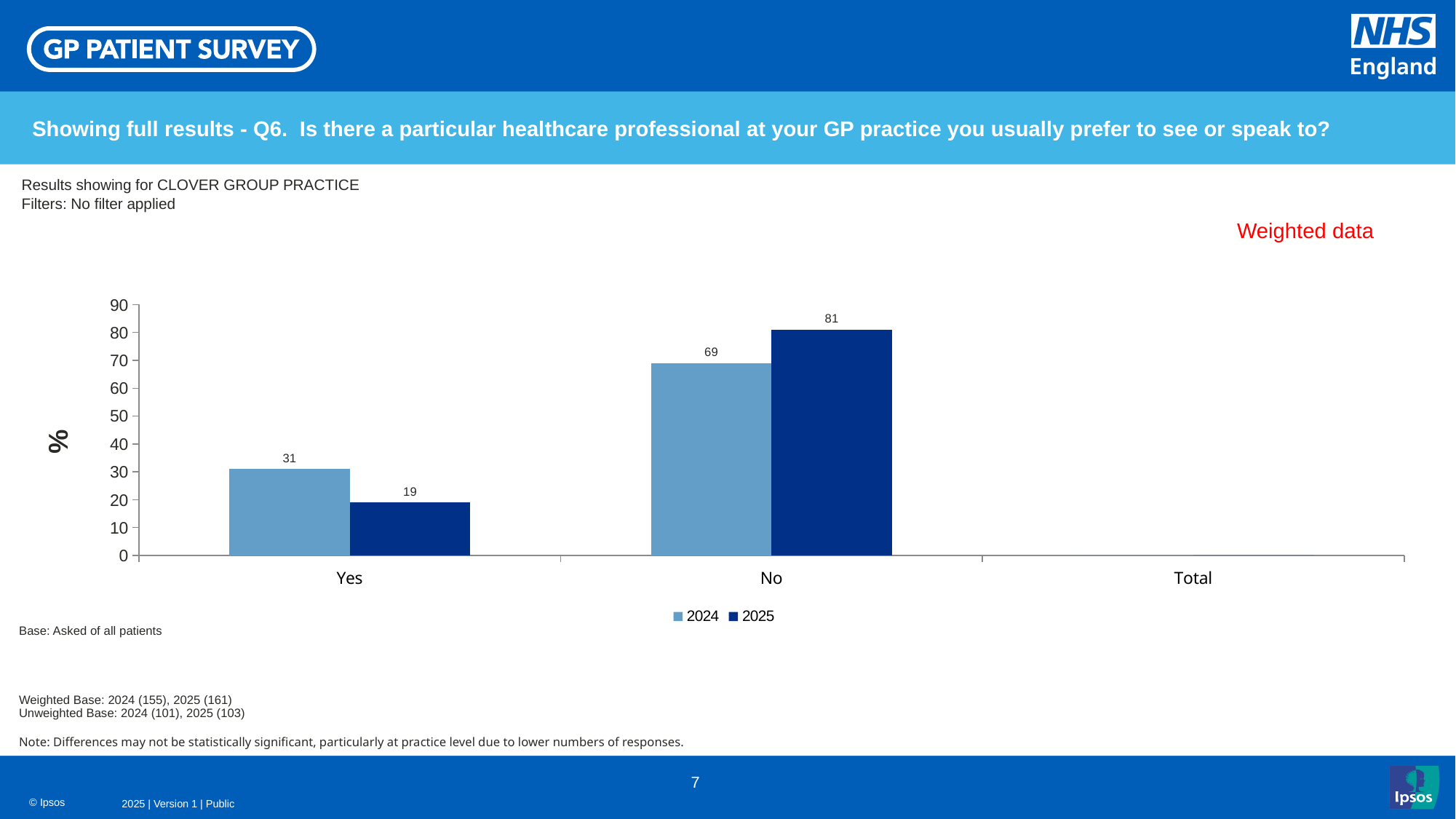
What kind of chart is shown on the slide? Bar chart Which is larger for 'Yes': the 2024 value or the 2025 value? 2024 Which category has the highest value in the 2025 series? No What is the value for 'Yes' in 2024? 31 What is the difference between the 2024 and 2025 values for 'Yes'? 12 What is the value for 'No' in 2025? 81 What is the value for 'Yes' in 2025? 19 Which category has the lowest value in the 2024 series? Yes What is the value for 'No' in 2024? 69 What label is shown on the vertical axis? % What is the difference between the 2024 and 2025 values for 'No'? 12 How many series does the legend list? 2